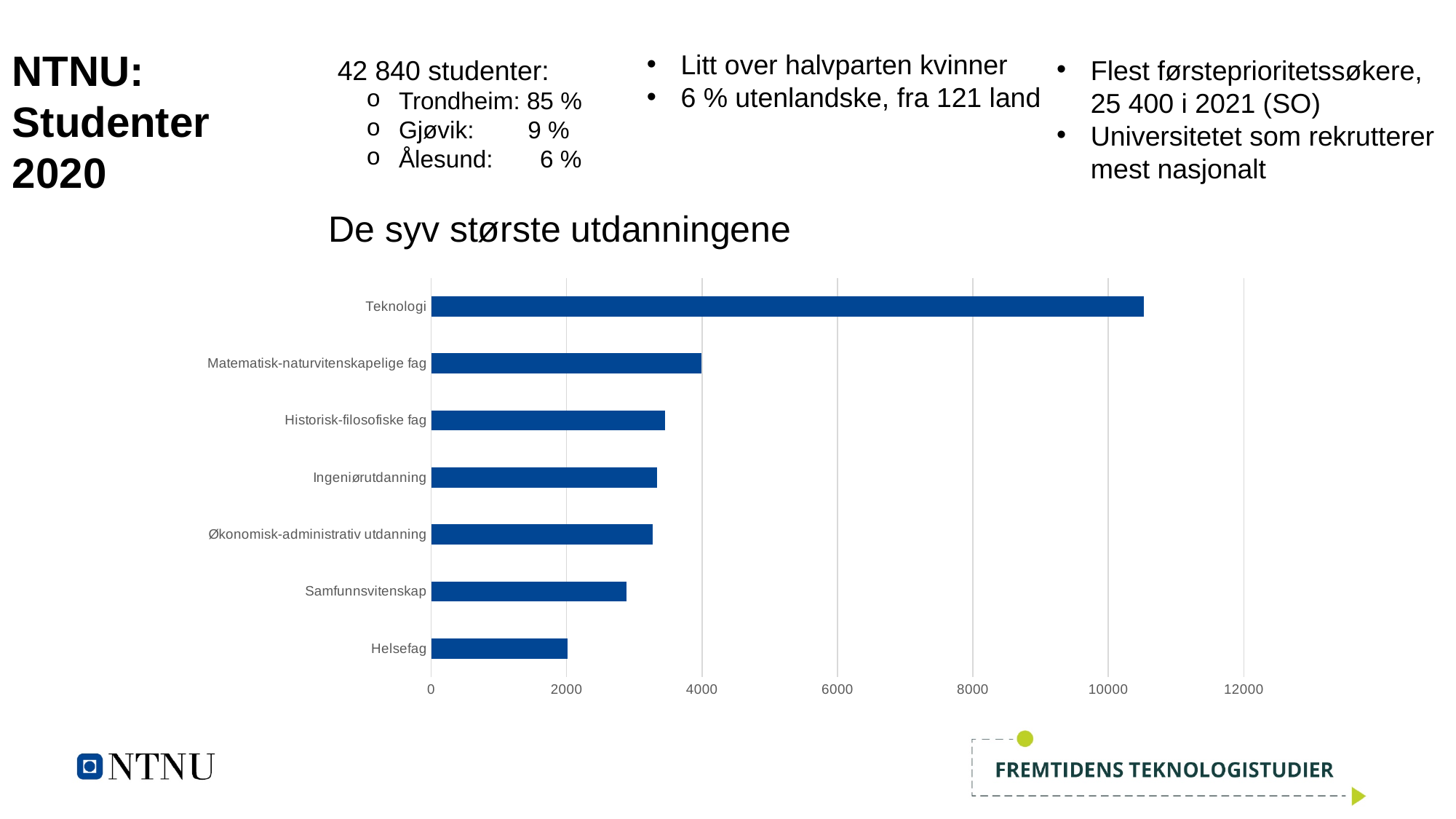
Which category has the lowest value in the chart? Helsefag What kind of chart is shown on the slide? bar chart Which is larger, the value for Samfunnsvitenskap or the value for Helsefag? Samfunnsvitenskap Do the bar values increase or decrease going from the top category to the bottom category? decrease What is the title of the chart? De syv største utdanningene Is the value for Historisk-filosofiske fag greater or less than 4000? less Is the value for Samfunnsvitenskap greater or less than 2000? greater Is the value for Helsefag greater or less than 4000? less Which category has the highest value in the chart? Teknologi How many categories are plotted in the chart? 7 Which is larger, the value for Teknologi or the value for Matematisk-naturvitenskapelige fag? Teknologi